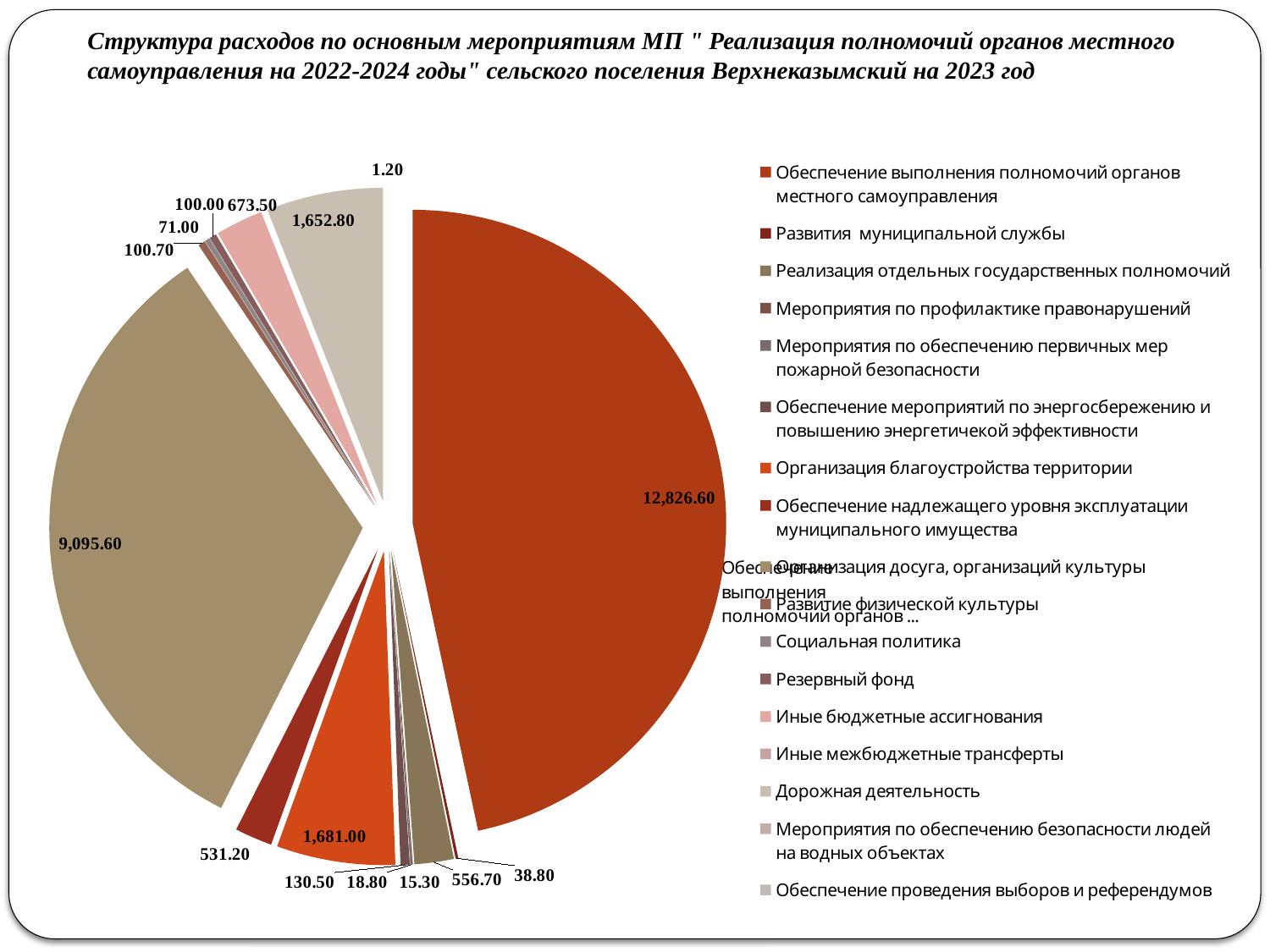
What is the value for Организация благоустройства территории? 1,681.00 What kind of chart is shown on the slide? pie chart What is the value for Дорожная деятельность? 1,652.80 Which is larger: the slice for Обеспечение выполнения полномочий органов местного самоуправления or the slice for Организация досуга, организаций культуры? Обеспечение выполнения полномочий органов местного самоуправления What is the value for Организация досуга, организаций культуры? 9,095.60 What is the smallest data label shown on the pie chart? 1.20 How many entries does the legend of the pie chart list? 17 What is the value of the largest slice of the pie chart? 12,826.60 Which category has the largest slice of the pie chart? Обеспечение выполнения полномочий органов местного самоуправления What is the difference between the value for Организация благоустройства территории (1,681.00) and the value for Дорожная деятельность (1,652.80)? 28.20 What is the difference between the value for Обеспечение выполнения полномочий органов местного самоуправления (12,826.60) and the value for Организация досуга, организаций культуры (9,095.60)? 3,731.00 What is the value for Иные бюджетные ассигнования? 673.50